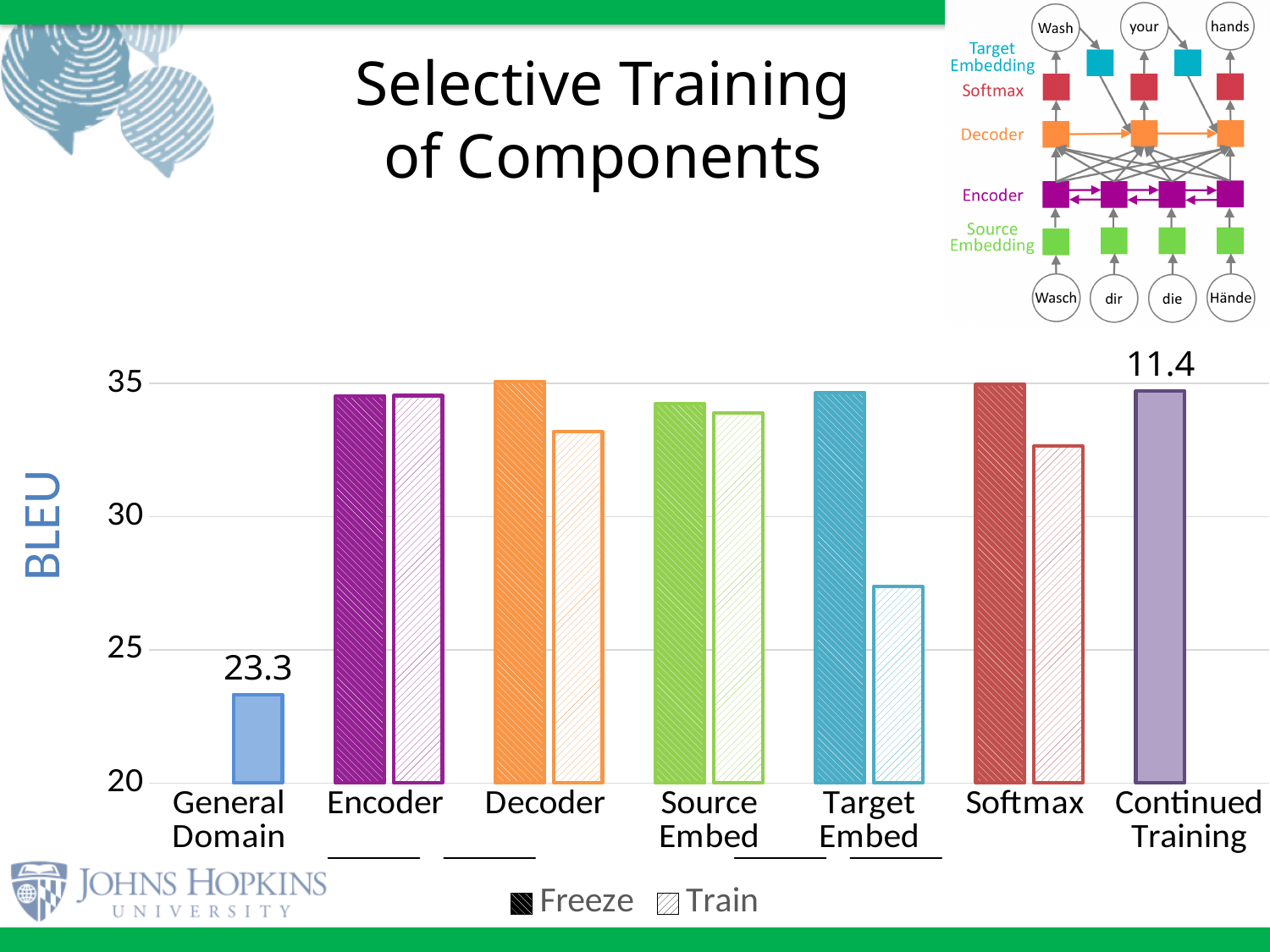
What number is printed above the Continued Training bar? 11.4 For Target Embed, which is larger, the Freeze bar or the Train bar? Freeze Is the Train value for Decoder greater or less than 30? greater Which category has the lowest bar in the chart? General Domain Is the Train value for Target Embed greater or less than 30? less What kind of chart is shown on the slide? bar chart What is the label on the y axis of the chart? BLEU What are the two series named in the legend? Freeze and Train How many series does the legend list? 2 Among the Train bars, which category has the lowest value? Target Embed How many categories are shown along the x axis of the chart? 7 What is the BLEU value printed for General Domain? 23.3